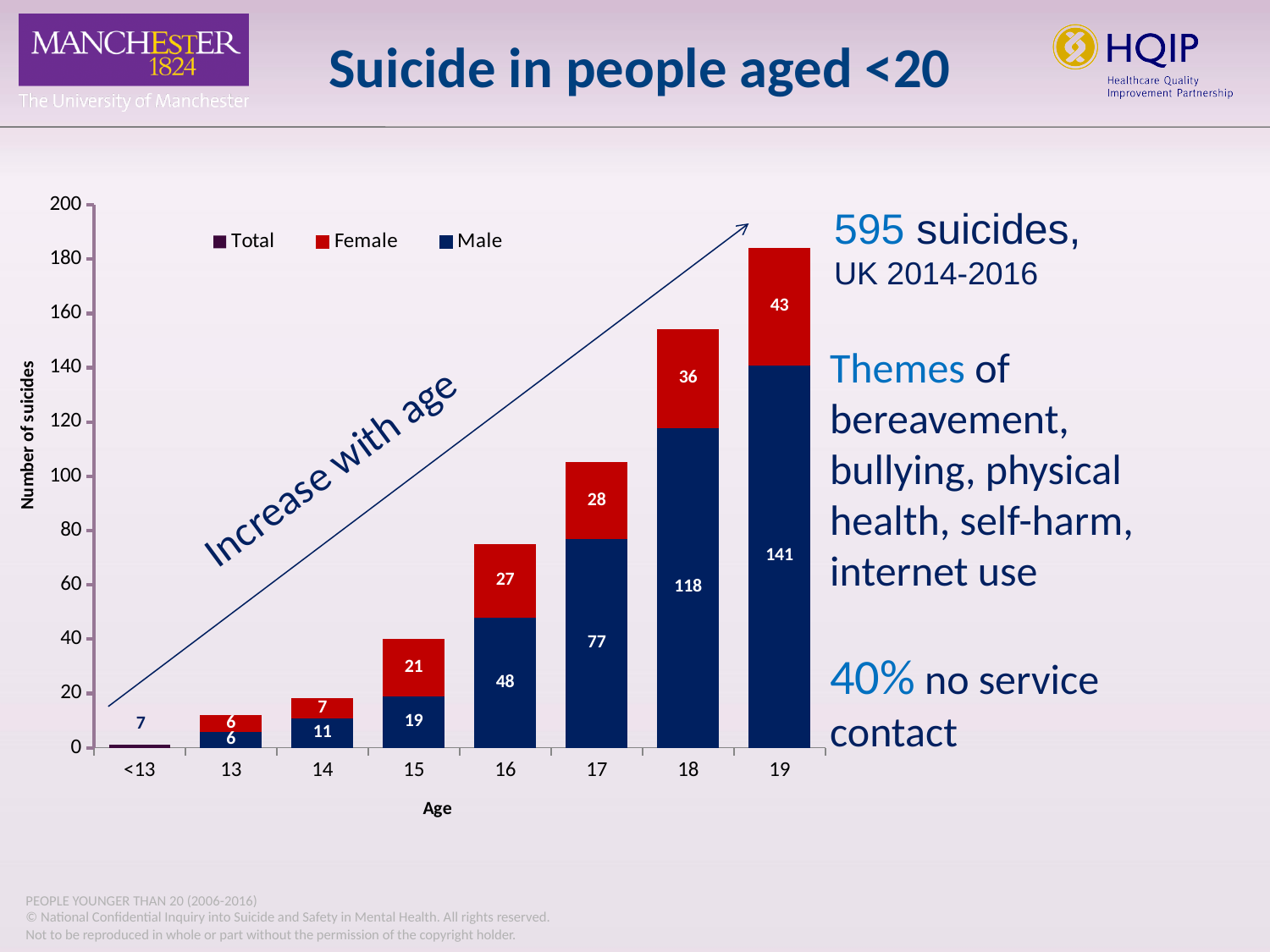
Which age category has the lowest Female value? 13 What is the total of the stacked bar for age 18? 154 What type of chart is shown on the slide? Stacked bar chart Do the number of suicides rise or fall as age increases along the x axis? rise What is the Male value for age 19? 141 Which age category has the highest Male value? 19 How many age categories are shown on the x axis? 8 What is the Male value for age 17? 77 What is the difference between the Male values for age 18 and age 17? 41 What is the Female value for age 16? 27 Is the Female value for age 15 larger or smaller than the Male value for age 15? larger How many series does the chart legend list? 3